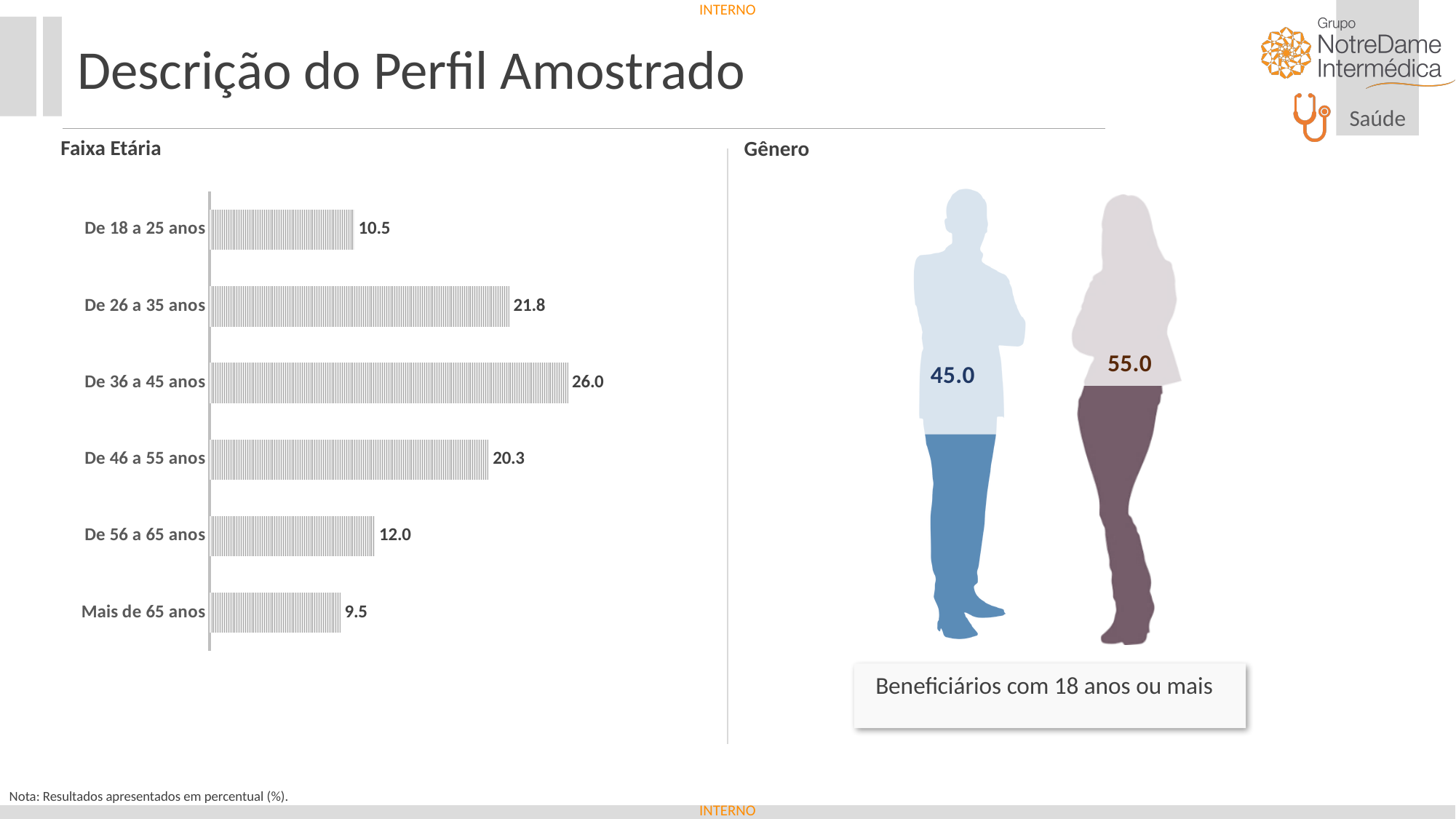
In the Faixa Etária chart, what is the difference between the values for De 26 a 35 anos and De 46 a 55 anos? 1.5 In the Faixa Etária chart, what is the value for Mais de 65 anos? 9.5 In the Gênero graphic, what is the value shown on the female figure? 55.0 In the Faixa Etária chart, what is the difference between the highest and lowest values? 16.5 In the Faixa Etária chart, what is the value for De 18 a 25 anos? 10.5 In the Faixa Etária chart, which age group has the lowest value? Mais de 65 anos In the Faixa Etária chart, which age group has the highest value? De 36 a 45 anos How many age groups are shown in the Faixa Etária chart? 6 In the Gênero graphic, what is the value shown on the male figure? 45.0 In the Faixa Etária chart, what is the value for De 36 a 45 anos? 26.0 What kind of chart is the Faixa Etária chart? Bar chart In the Faixa Etária chart, which is larger: the value for De 56 a 65 anos or the value for De 18 a 25 anos? De 56 a 65 anos